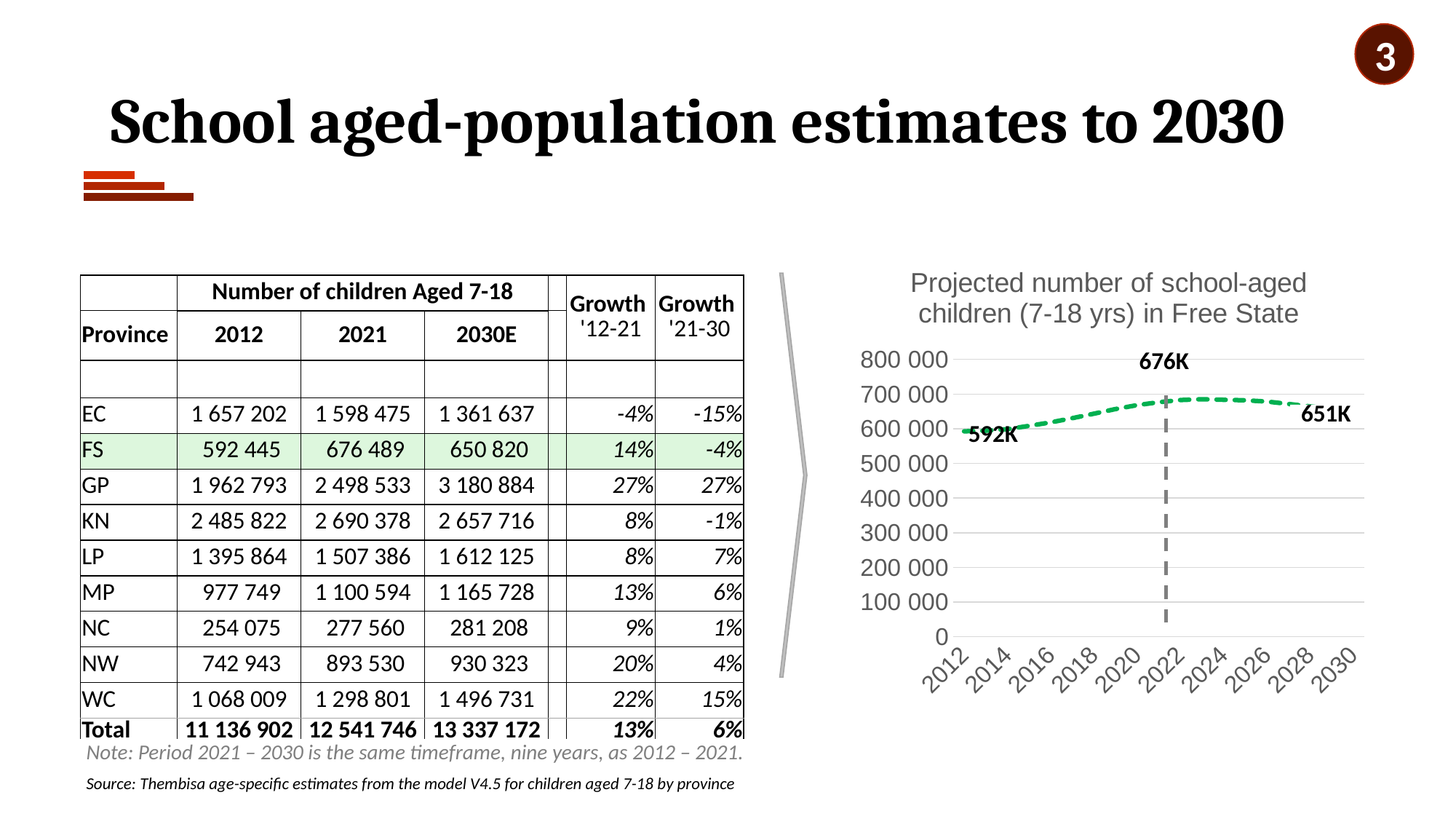
In the chart, what is the labelled value at the end of the line, around 2030? 651K In the chart, which labelled point is the highest? 676K What is the highest value shown on the chart's vertical axis? 800 000 In the chart, is the value for 2012 greater or less than 700 000? less In the chart, does the line rise or fall after its peak around 2021 towards 2030? fall In the chart, is the labelled value 676K larger than the labelled value 651K? Yes In the chart, what is the labelled value at the peak of the line, around 2021? 676K What is the title of the chart on the right of the slide? Projected number of school-aged children (7-18 yrs) in Free State In the chart, does the line rise or fall between 2012 and 2021? rise In the chart, which labelled point is the lowest? 592K In the chart, what is the labelled value for 2012? 592K What kind of chart is shown on the right of the slide? line chart